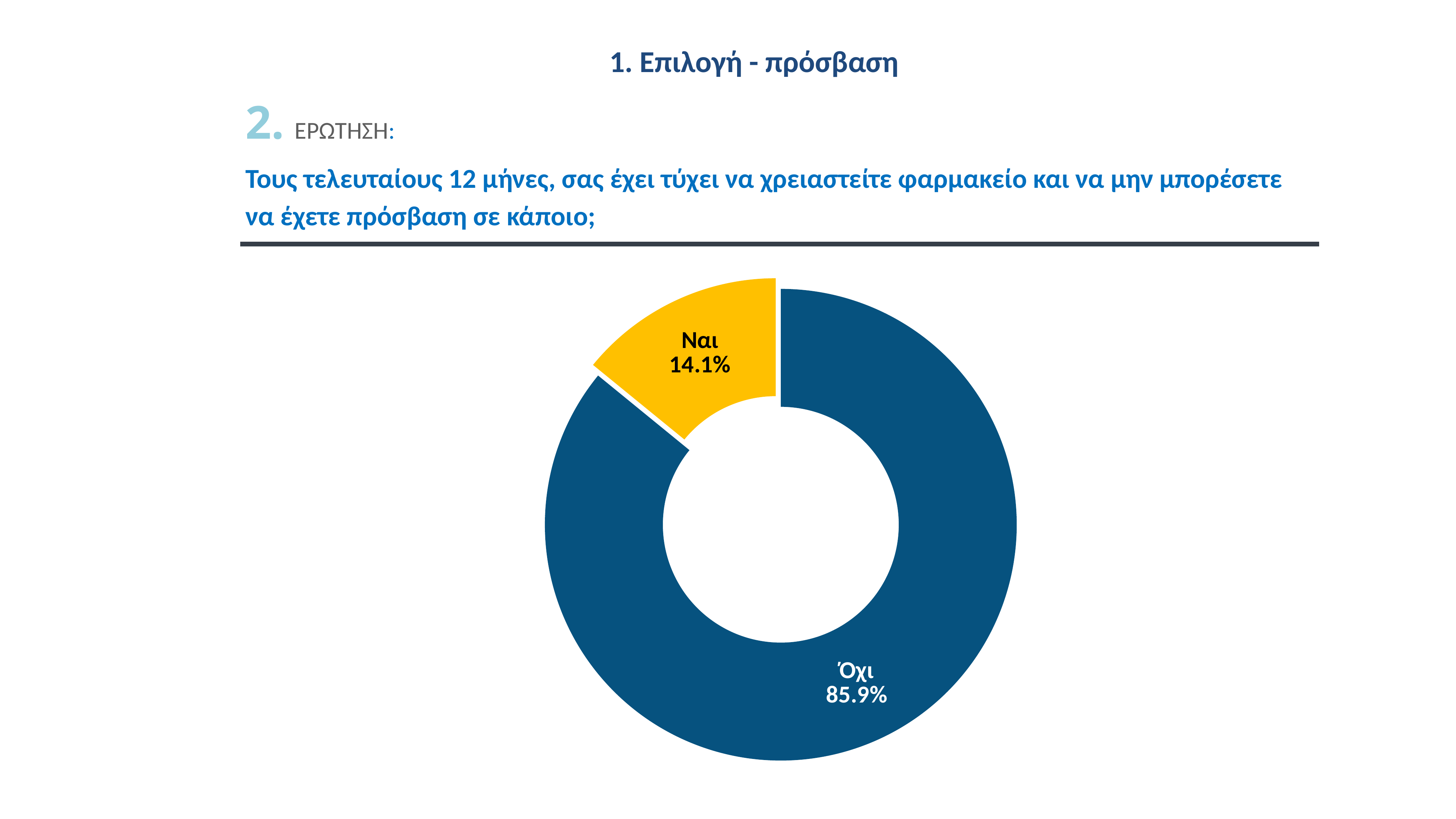
What percentage of respondents answered Όχι? 85.9% What colour is the Όχι slice? Dark blue How many categories are shown in the chart? 2 What colour is the Ναι slice? Yellow What percentage of respondents answered Ναι? 14.1% What share of the chart does the Ναι slice represent? 14.1% Which response has the largest share of the chart? Όχι What is the difference in percentage points between Όχι and Ναι? 71.8 What kind of chart is shown on the slide? Doughnut chart Which is larger, the share for Ναι or the share for Όχι? Όχι What is the total of the two slices shown? 100% Which response has the smallest share of the chart? Ναι